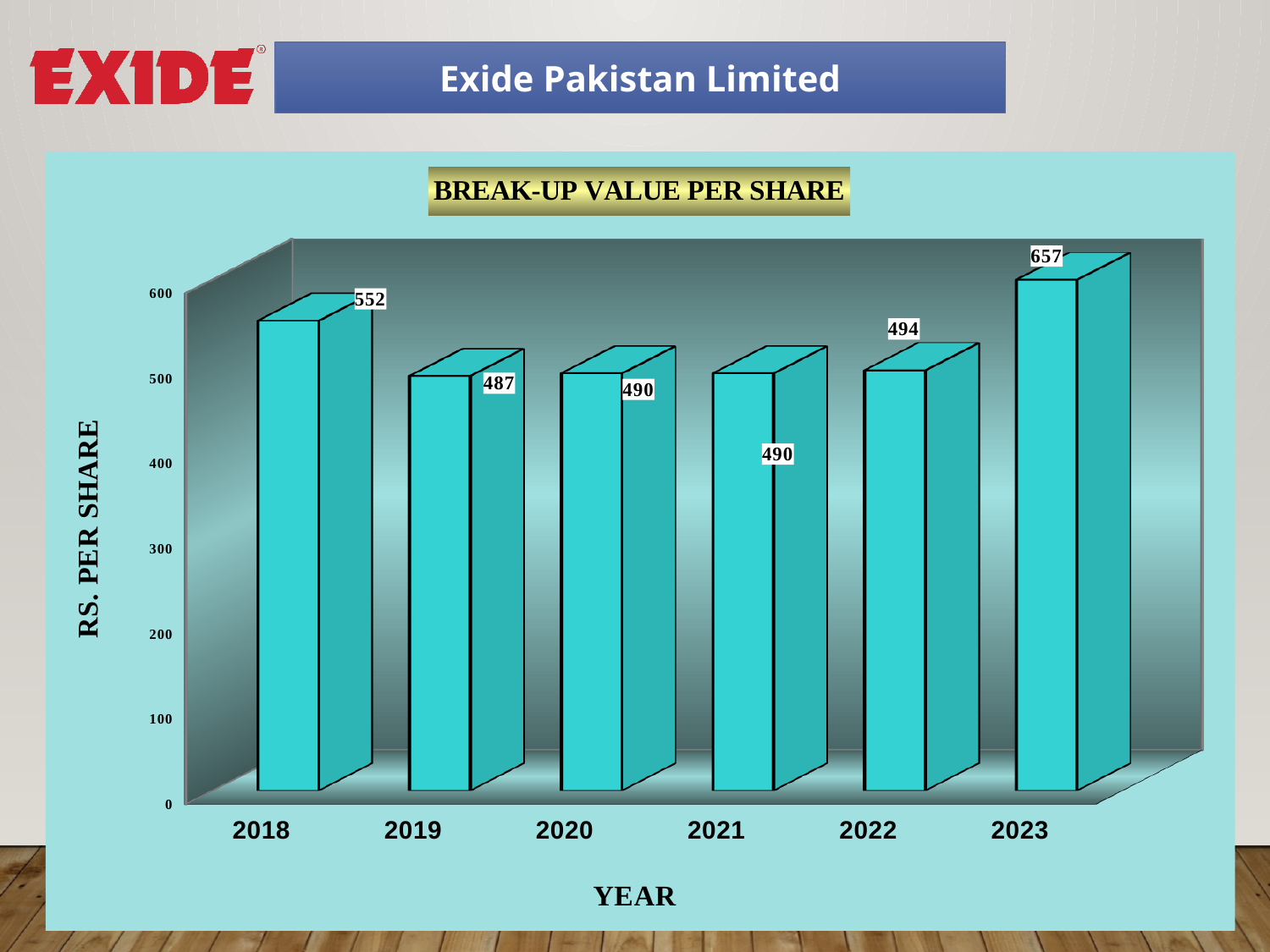
What is the difference between the break-up value per share in 2022 and 2021? 4 What is the difference between the break-up value per share in 2023 and 2018? 105 Which year has the highest break-up value per share? 2023 What is the break-up value per share for 2018? 552 What is the break-up value per share for 2023? 657 What is the break-up value per share for 2022? 494 Which year has the lowest break-up value per share? 2019 Is the break-up value per share for 2023 greater or less than 600? greater What is the break-up value per share for 2019? 487 How many years are shown on the chart? 6 Which year has a larger break-up value per share, 2018 or 2022? 2018 What type of chart is shown on the slide? Bar chart